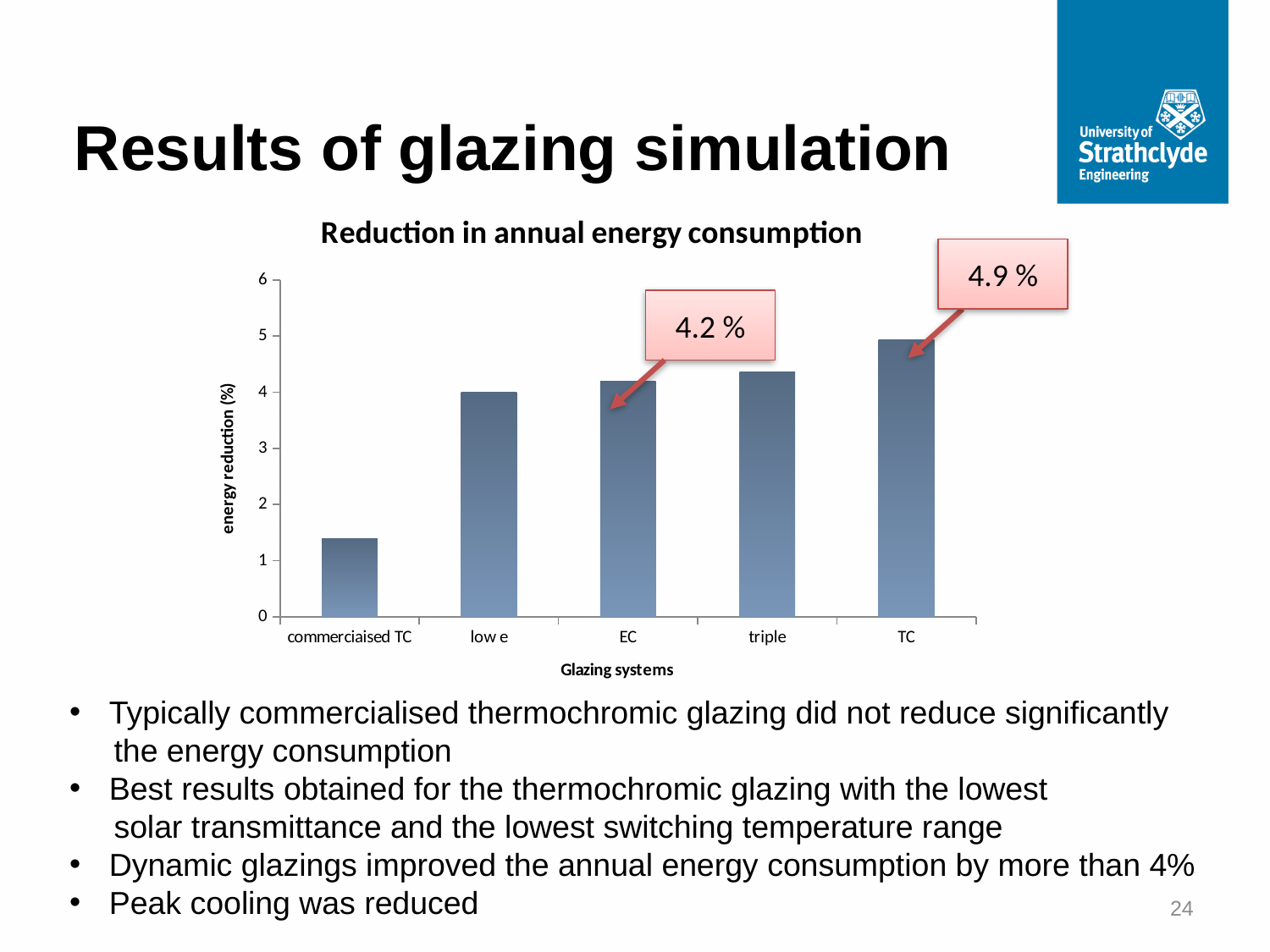
Do the bar values rise or fall from left to right along the x axis? rise What is the title of the chart? Reduction in annual energy consumption Which has a larger energy reduction, triple or commerciaised TC? triple Which glazing system has the highest energy reduction? TC How many glazing systems are plotted on the chart? 5 Is the value for commerciaised TC greater or less than 2? less Which glazing system has the lowest energy reduction? commerciaised TC Is the value for triple greater or less than 4? greater What is the difference between the labelled values for TC and EC? 0.7 % What is the energy reduction value labelled for EC? 4.2 % What type of chart is shown on the slide? bar chart What is the energy reduction value labelled for TC? 4.9 %